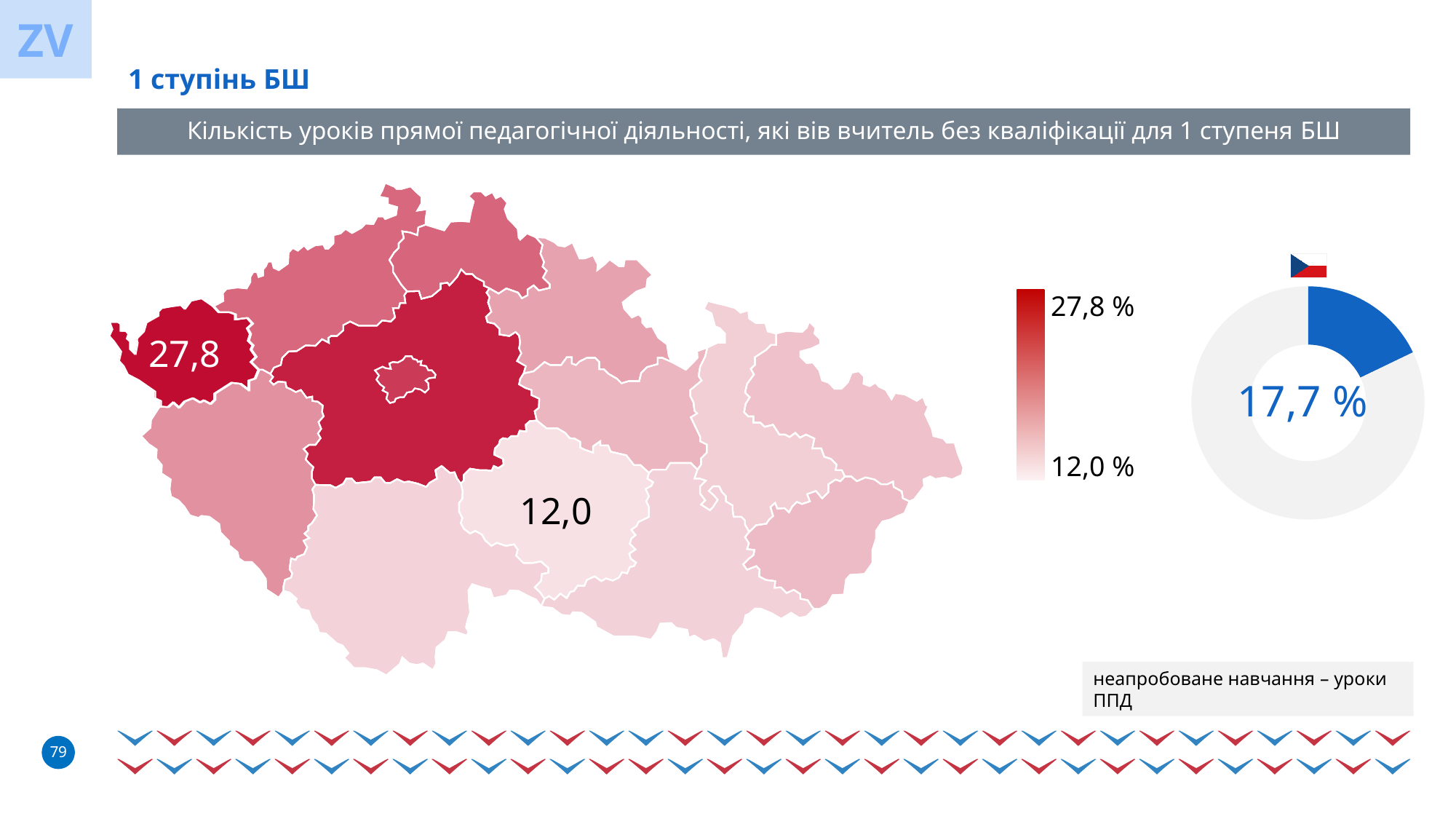
What is the title of the chart on the slide? Кількість уроків прямої педагогічної діяльності, які вів вчитель без кваліфікації для 1 ступеня БШ On the map, what is the highest value printed for a region? 27,8 Which region on the map is shaded the darkest red? The westernmost region, labelled 27,8 On the map, what is the lowest value printed for a region? 12,0 What kind of chart is the main visual on the left of the slide? Choropleth map What kind of chart is shown on the right side of the slide? Donut (pie) chart What is the maximum value shown on the colour scale next to the map? 27,8 % Which is larger: the value of the westernmost region on the map or the value in the donut chart? The westernmost region (27,8) What value is shown in the centre of the donut chart on the right? 17,7 % On the map, what is the difference between the highest labelled value (27,8) and the lowest labelled value (12,0)? 15,8 What is the minimum value shown on the colour scale next to the map? 12,0 % Which is larger: the value in the donut chart (17,7 %) or the lowest region value on the map (12,0)? 17,7 %